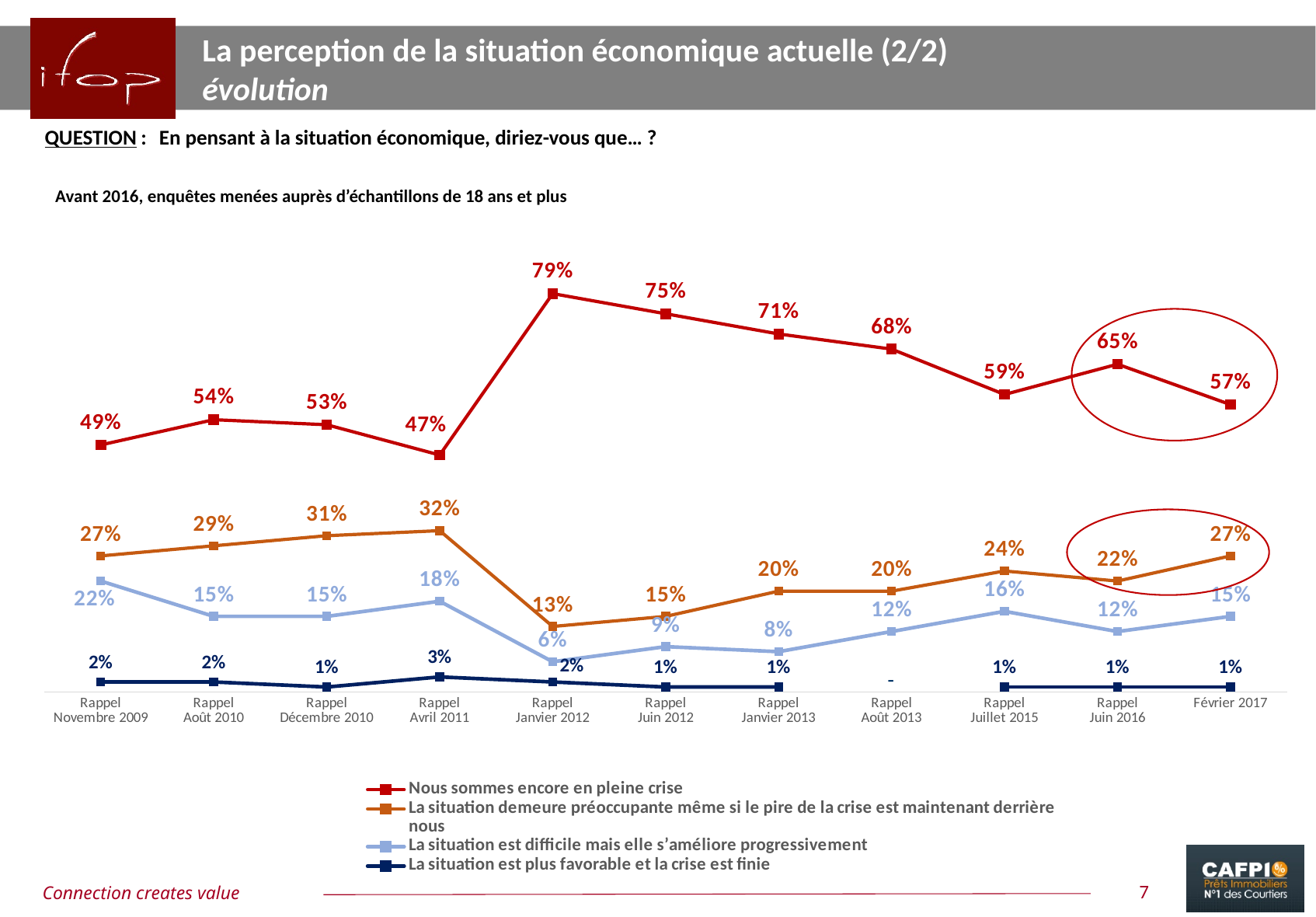
What is the value for "La situation demeure préoccupante même si le pire de la crise est maintenant derrière nous" in Rappel Avril 2011? 32% How many series does the legend list? 4 What is the value for "Nous sommes encore en pleine crise" in Février 2017? 57% At which time point is "La situation demeure préoccupante même si le pire de la crise est maintenant derrière nous" at its lowest? Rappel Janvier 2012 Which series is drawn in red? Nous sommes encore en pleine crise What kind of chart is shown on the slide? Line chart Does "Nous sommes encore en pleine crise" rise or fall from Rappel Janvier 2012 to Rappel Juillet 2015? Fall Which is larger: "La situation est difficile mais elle s'améliore progressivement" in Rappel Novembre 2009 or in Rappel Juillet 2015? Rappel Novembre 2009 At which time point does "Nous sommes encore en pleine crise" reach its highest value? Rappel Janvier 2012 What is the value for "La situation est difficile mais elle s'améliore progressivement" in Rappel Janvier 2012? 6% How many time points are shown on the x axis? 11 What is the difference between the "Nous sommes encore en pleine crise" values for Rappel Juin 2016 and Février 2017? 8 percentage points